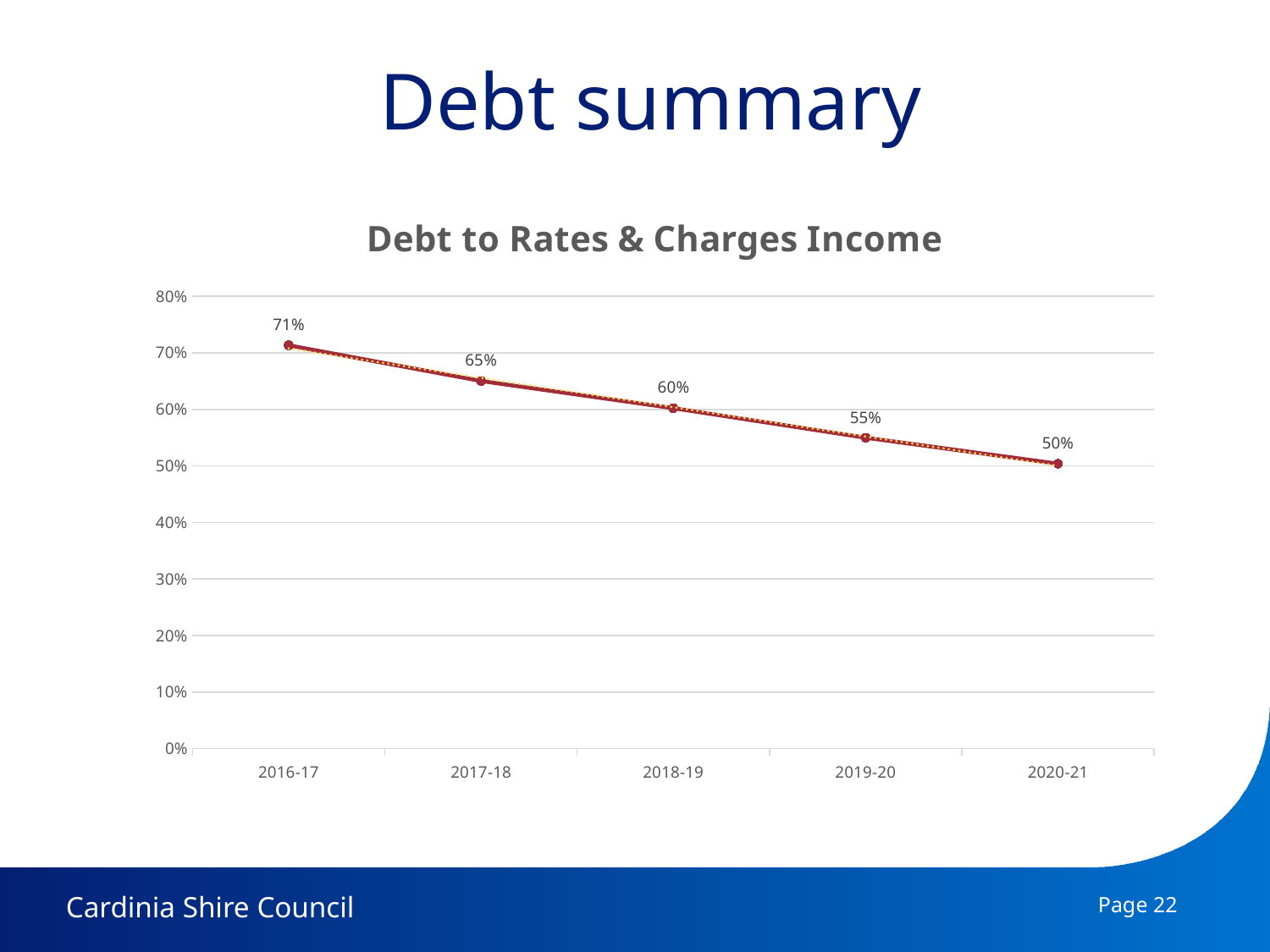
What is the value for 2018-19? 60% Which year has the lowest Debt to Rates & Charges Income value? 2020-21 Which year has the highest Debt to Rates & Charges Income value? 2016-17 Which is larger, the value for 2017-18 or the value for 2019-20? 2017-18 Is the value for 2018-19 greater or less than 70%? less What is the difference between the values for 2017-18 and 2019-20? 10% What is the difference between the values for 2016-17 and 2020-21? 21% What kind of chart is shown on the slide? line chart What is the value for 2020-21? 50% How many years are plotted on the chart? 5 What is the value for 2016-17? 71% Do the values rise or fall from 2016-17 to 2020-21? fall